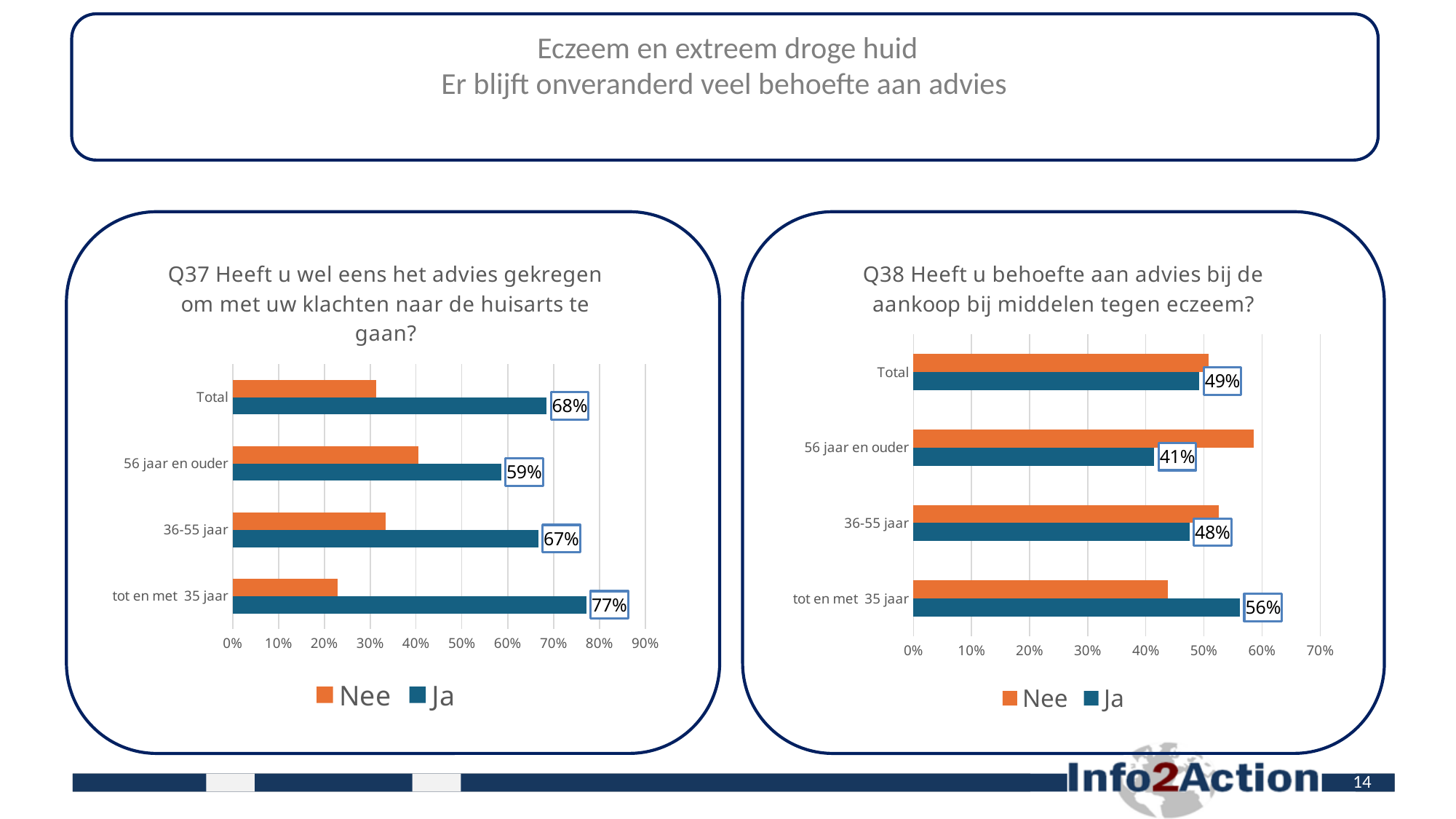
In the Q37 chart (left), what is the difference between the 'Ja' values for 'tot en met 35 jaar' and '56 jaar en ouder'? 18 percentage points In the Q37 chart (left), is the 'Nee' value for 'tot en met 35 jaar' greater or less than 30%? less In the Q38 chart (right), which is larger for 'tot en met 35 jaar': the 'Ja' value or the 'Nee' value? Ja In the Q37 chart (left), what is the 'Ja' value for 'tot en met 35 jaar'? 77% In the Q38 chart (right), what is the 'Ja' value for '36-55 jaar'? 48% In the Q37 chart (left), which category has the highest 'Ja' value? tot en met 35 jaar What kind of chart is the Q37 chart (left)? Bar chart In the Q37 chart (left), what is the 'Ja' value for '56 jaar en ouder'? 59% How many series does the legend of the Q38 chart (right) list? 2 In the Q38 chart (right), what is the 'Ja' value for 'Total'? 49% In the Q38 chart (right), which category has the lowest 'Ja' value? 56 jaar en ouder In the Q38 chart (right), is the 'Nee' value for '56 jaar en ouder' greater or less than 50%? greater